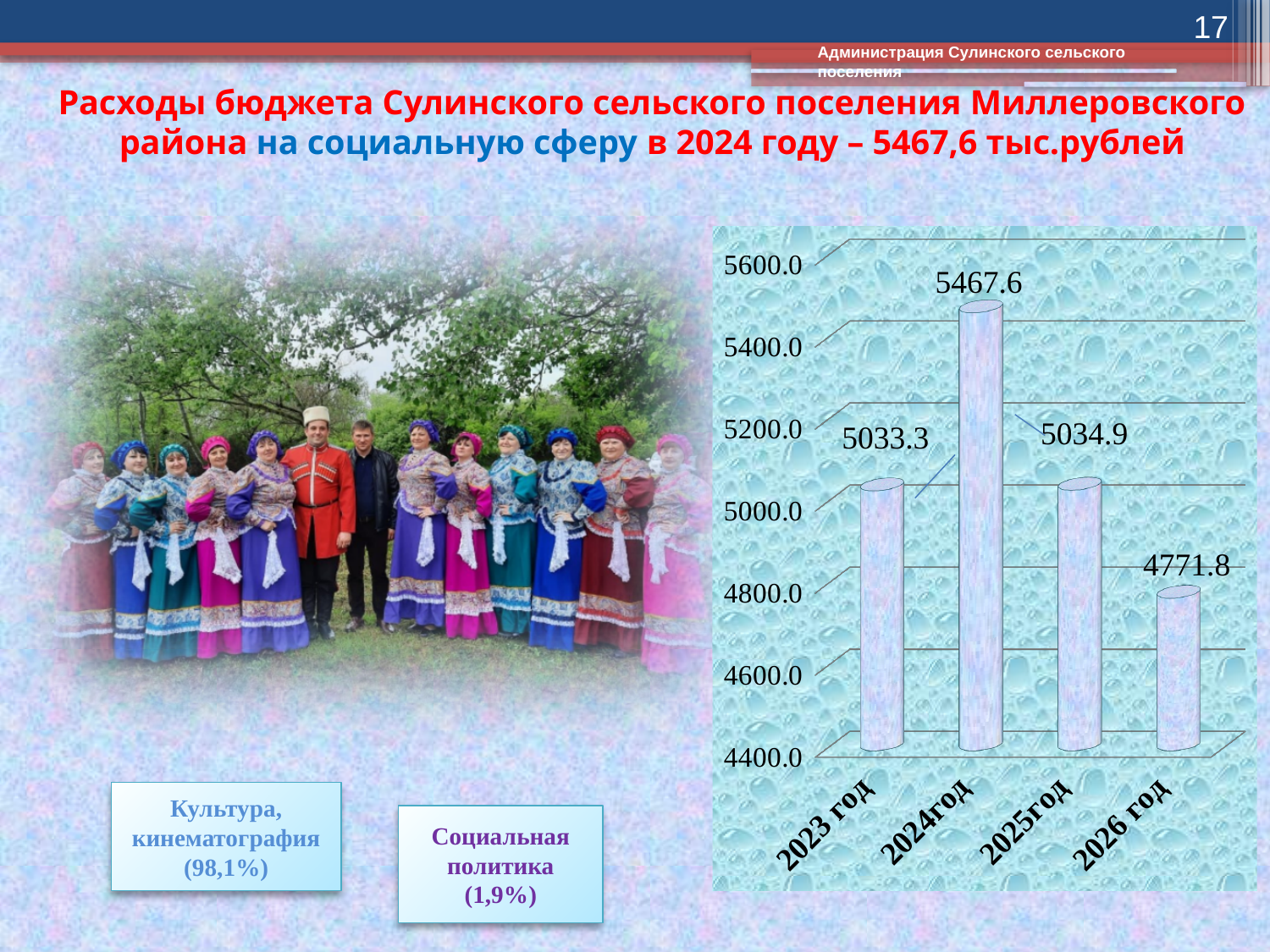
Is the value for 2026 год greater or less than 4800.0? less What is the value for 2024год in the chart? 5467.6 What is the value for 2025год in the chart? 5034.9 Which is larger, the value for 2024год or the value for 2026 год? 2024год What is the difference between the values for 2025год and 2026 год? 263.1 What is the value for 2023 год in the chart? 5033.3 What is the value for 2026 год in the chart? 4771.8 What is the difference between the values for 2024год and 2023 год? 434.3 Which year has the highest value in the chart? 2024год What kind of chart is shown on the slide? bar chart How many years are shown in the chart? 4 Which year has the lowest value in the chart? 2026 год